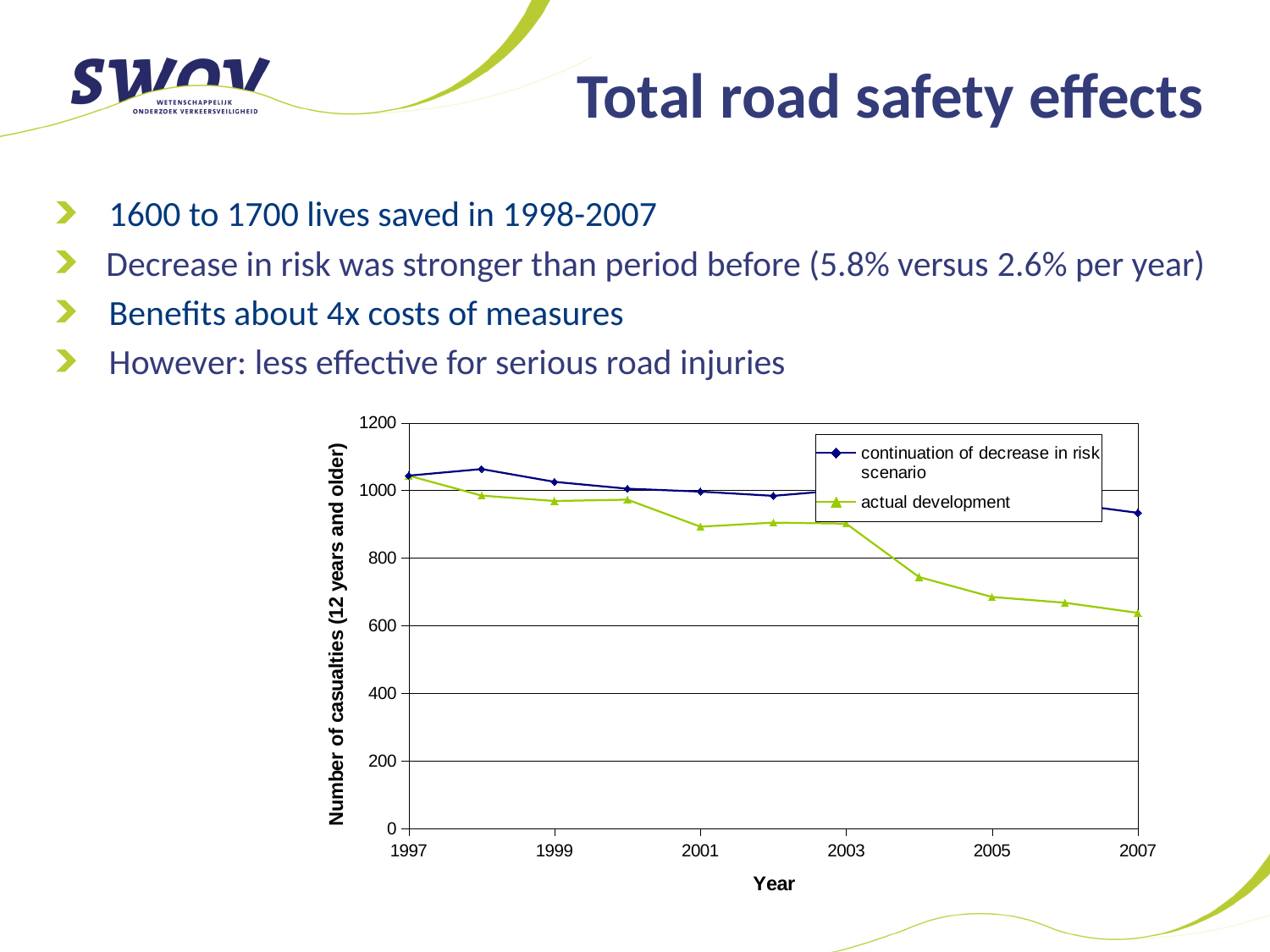
In 2007, which series has the higher value: 'continuation of decrease in risk scenario' or 'actual development'? continuation of decrease in risk scenario Is the 'actual development' value for 2007 greater or less than 800? less Is the 'actual development' value for 2004 greater or less than 800? less Is the 'actual development' value for 2001 greater or less than 1000? less In which year is the 'actual development' series at its highest? 1997 What are the two series named in the chart legend? continuation of decrease in risk scenario; actual development In which year is the 'actual development' series at its lowest? 2007 What is the label of the chart's vertical axis? Number of casualties (12 years and older) What kind of chart is shown on the slide? line chart How many series does the chart legend list? 2 Does the 'actual development' series rise or fall from 1997 to 2007? fall